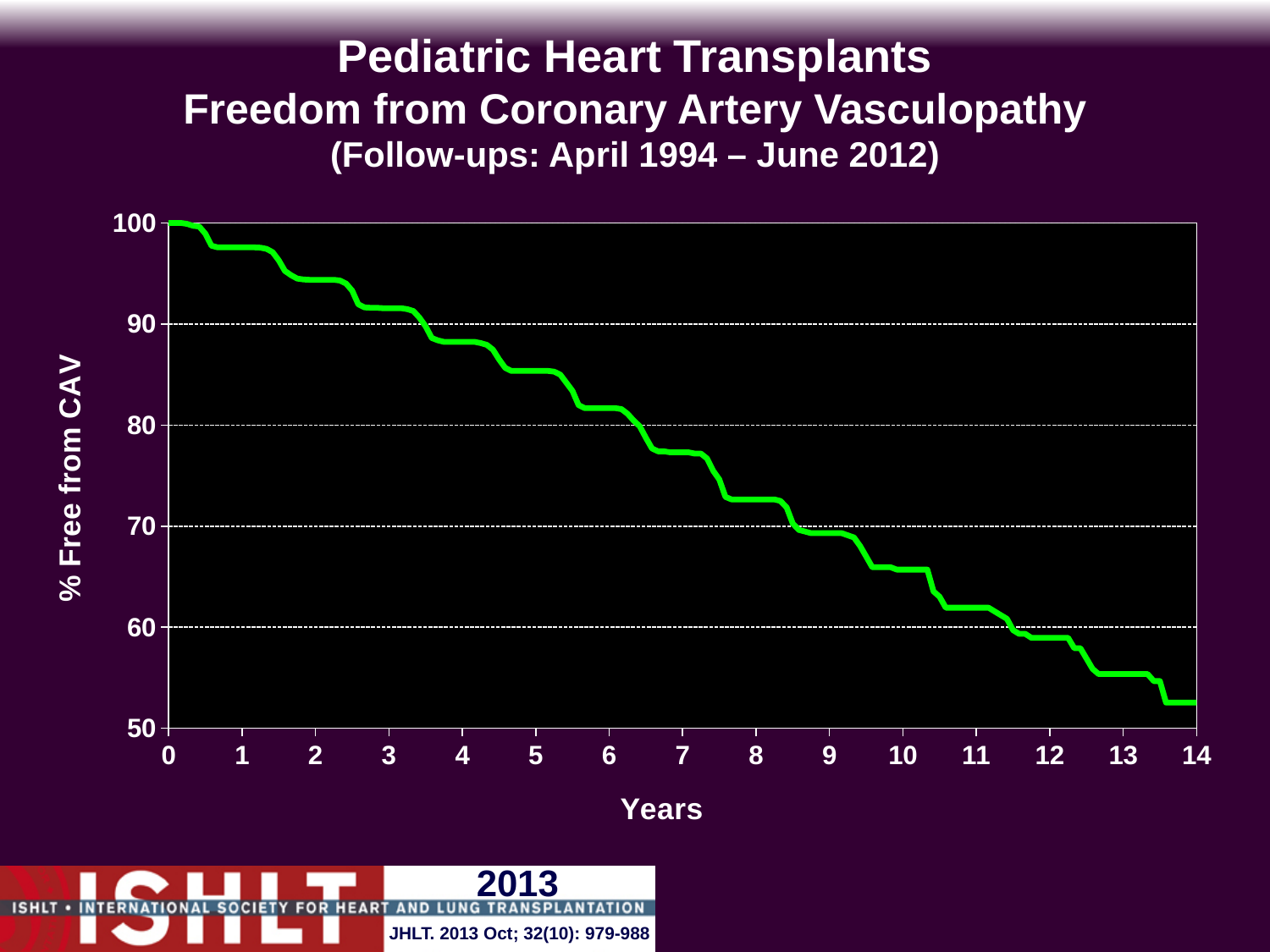
Is the % Free from CAV at year 4 greater or less than 90? less What is the label of the y axis? % Free from CAV Is the % Free from CAV at year 14 greater or less than 50? greater Does the % Free from CAV rise or fall as Years increase along the x axis? fall Is the % Free from CAV at year 7 greater or less than 80? less Which is larger, the % Free from CAV at year 3 or at year 9? year 3 What kind of chart is shown on the slide? line chart What is the % Free from CAV at year 0? 100